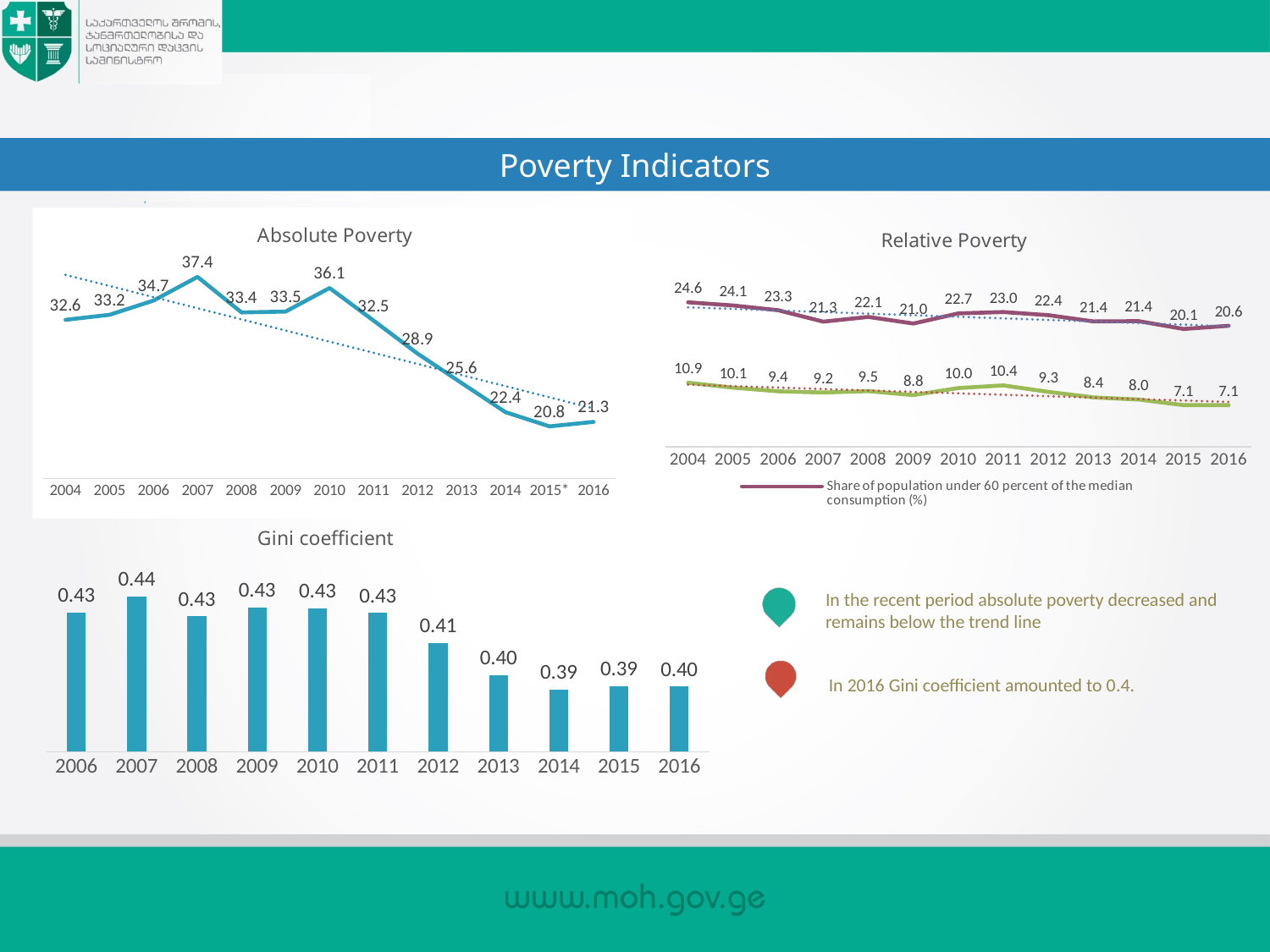
In the Absolute Poverty chart, which year has the larger value, 2010 or 2011? 2010 In the Relative Poverty chart, what is the value of the lower (green) line in 2016? 7.1 In the Gini coefficient chart, what is the value for 2007? 0.44 In the Absolute Poverty chart, which year has the highest value? 2007 In the Relative Poverty chart, how many years are shown on the x axis? 13 In the Relative Poverty chart, what is the share of population under 60 percent of the median consumption in 2004? 24.6 In the Absolute Poverty chart, what is the value for 2007? 37.4 In the Absolute Poverty chart, which year has the lowest value? 2015 In the Absolute Poverty chart, do the values rise or fall from 2010 to 2015? fall In the Absolute Poverty chart, what is the difference between the 2007 value and the 2016 value? 16.1 In the Gini coefficient chart, which years have the lowest value? 2014 and 2015 What kind of chart is the Gini coefficient chart? bar chart